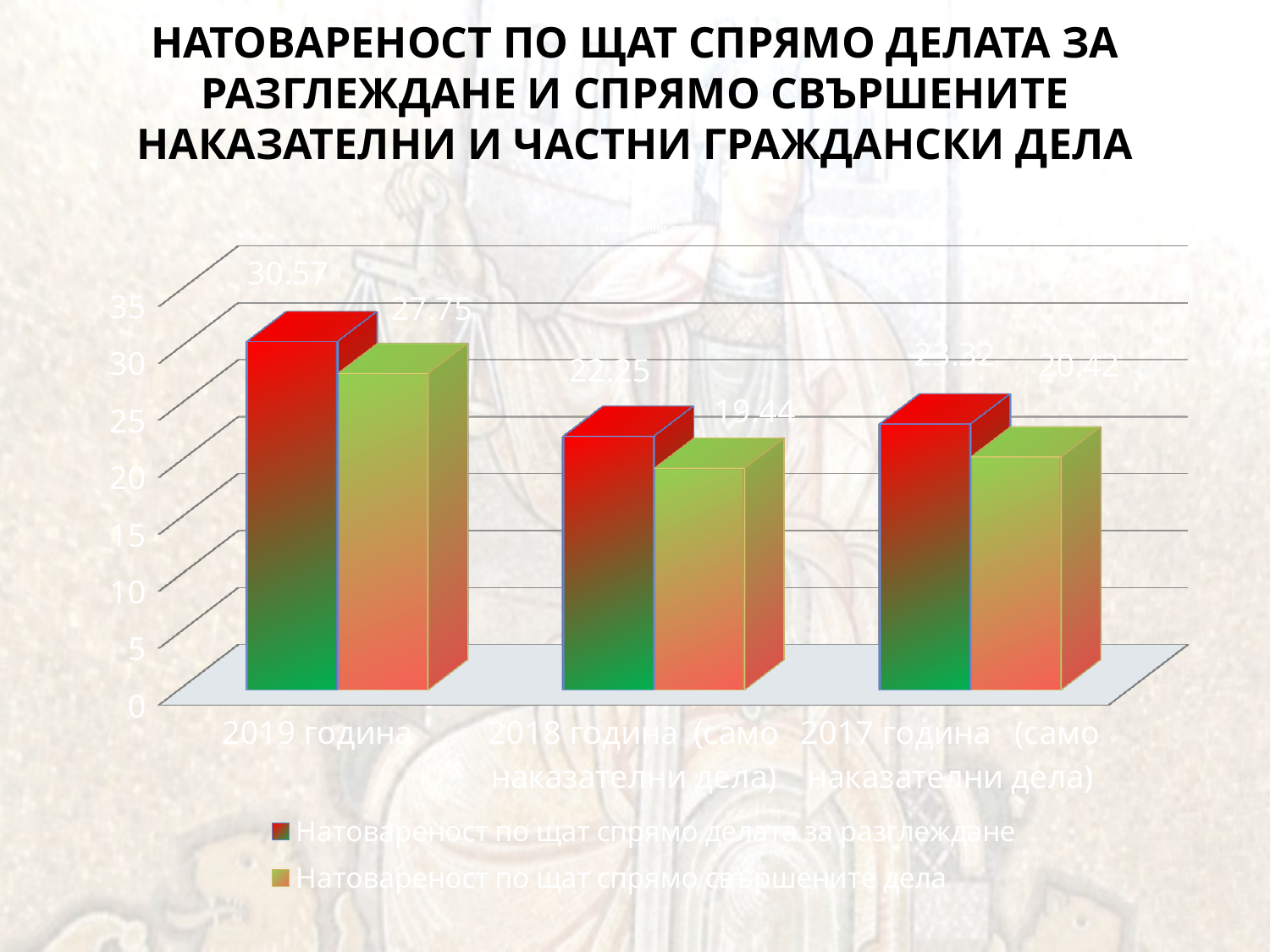
What colour are the bars for 'Натовареност по щат спрямо свършените дела'? Green What is the value of 'Натовареност по щат спрямо делата за разглеждане' for 2019 година? 30.57 Which category has the lowest value for 'Натовареност по щат спрямо свършените дела'? 2018 година (само наказателни дела) Which is larger: 'Натовареност по щат спрямо делата за разглеждане' for 2017 година or for 2018 година? 2017 година How many categories are shown on the x axis? 3 How many series does the legend list? 2 What is the value of 'Натовареност по щат спрямо делата за разглеждане' for 2018 година (само наказателни дела)? 22.25 What is the difference between the two series values for 2019 година? 2.82 What is the value of 'Натовареност по щат спрямо свършените дела' for 2017 година (само наказателни дела)? 20.42 What kind of chart is shown on the slide? Bar chart Which category has the highest value for 'Натовареност по щат спрямо делата за разглеждане'? 2019 година What is the value of 'Натовареност по щат спрямо свършените дела' for 2019 година? 27.75